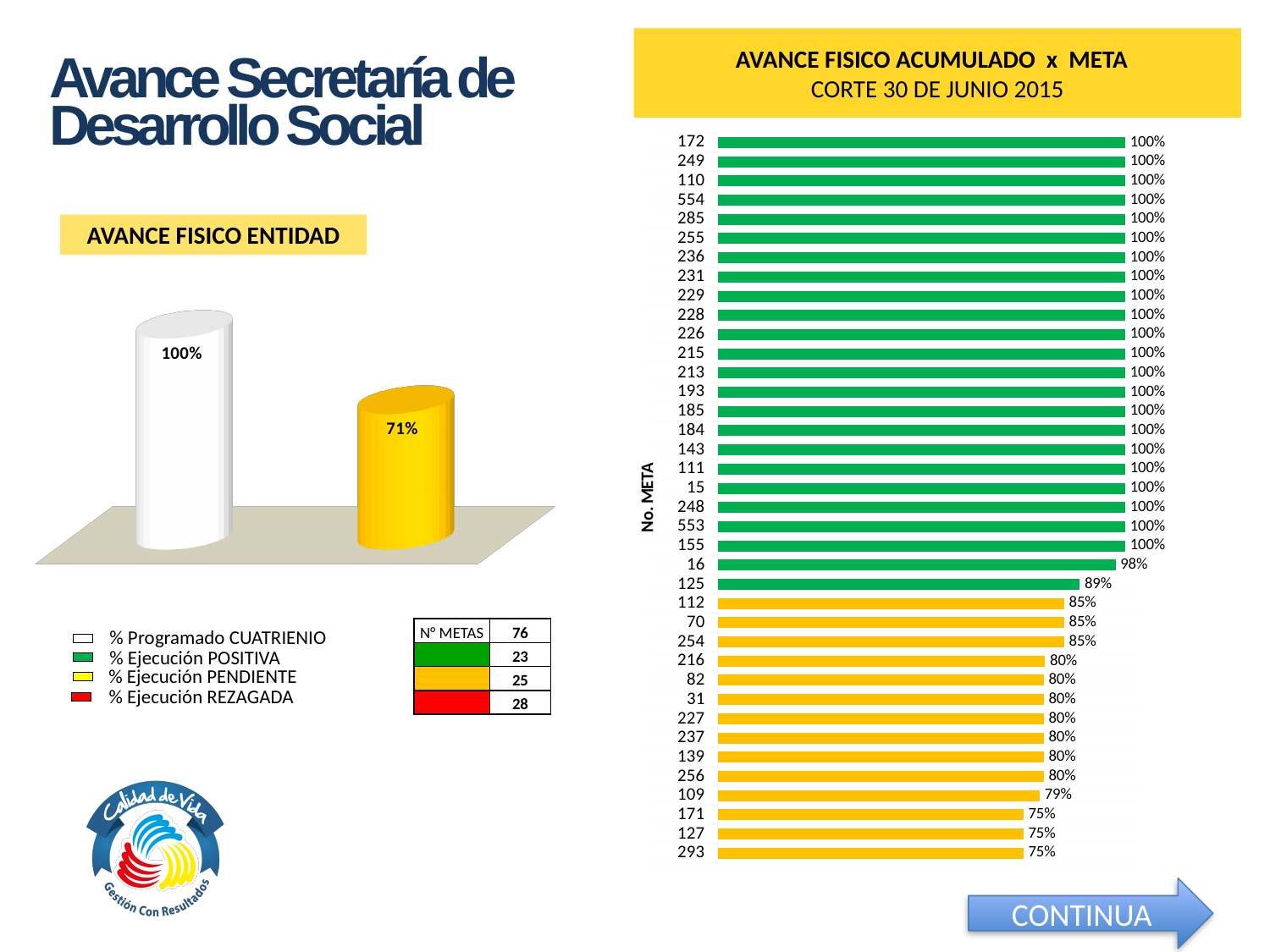
In the AVANCE FISICO ACUMULADO x META chart, what is the value for meta 109? 79% In the AVANCE FISICO ACUMULADO x META chart, what is the value for meta 16? 98% In the AVANCE FISICO ACUMULADO x META chart, what is the lowest value shown? 75% In the AVANCE FISICO ACUMULADO x META chart, which has the larger value, meta 112 or meta 216? meta 112 In the AVANCE FISICO ACUMULADO x META chart, what is the value for meta 125? 89% In the AVANCE FISICO ENTIDAD chart, what value is labelled on the white bar? 100% What kind of chart is the AVANCE FISICO ENTIDAD chart? bar chart In the AVANCE FISICO ACUMULADO x META chart, what is the value for meta 70? 85% In the AVANCE FISICO ACUMULADO x META chart, what is the difference between the values for meta 16 and meta 125? 9% In the AVANCE FISICO ENTIDAD chart, what value is labelled on the yellow bar? 71% What is the title of the chart on the right side of the slide? AVANCE FISICO ACUMULADO x META In the AVANCE FISICO ENTIDAD chart, what is the difference between the white bar's value and the yellow bar's value? 29%